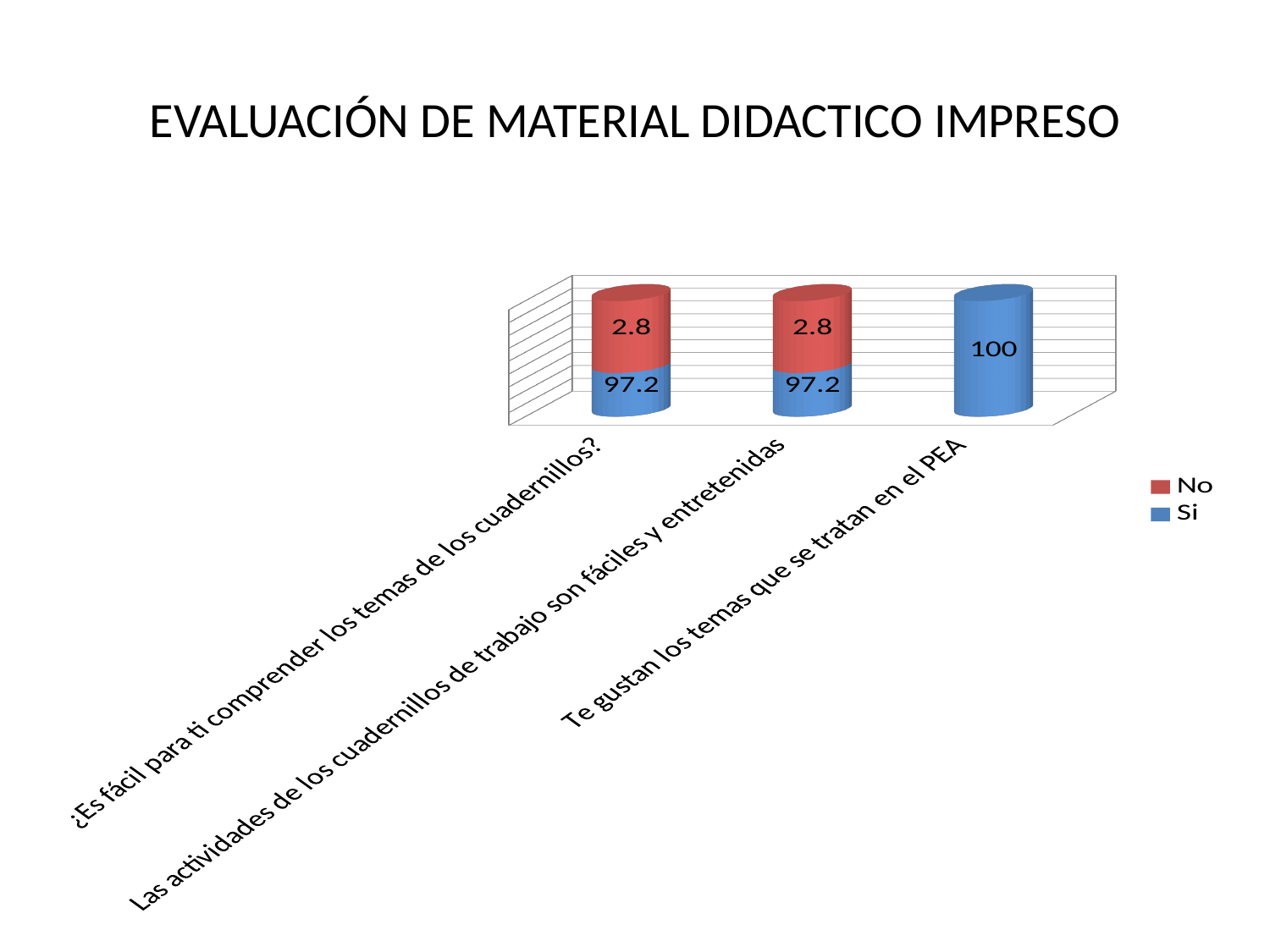
What is the total of the stacked bar for "¿Es fácil para ti comprender los temas de los cuadernillos?"? 100 What is the value of the "No" series for "¿Es fácil para ti comprender los temas de los cuadernillos?"? 2.8 How many categories are shown on the x axis? 3 How many series does the legend list? 2 What is the title of the slide? EVALUACIÓN DE MATERIAL DIDACTICO IMPRESO What is the value of the "No" series for "Las actividades de los cuadernillos de trabajo son fáciles y entretenidas"? 2.8 What kind of chart is shown on the slide? Stacked bar chart What is the value of the "Si" series for "Te gustan los temas que se tratan en el PEA"? 100 Which category has the highest "Si" value? Te gustan los temas que se tratan en el PEA For "¿Es fácil para ti comprender los temas de los cuadernillos?", which is larger, the "Si" value or the "No" value? Si What is the difference between the "Si" and "No" values for "Las actividades de los cuadernillos de trabajo son fáciles y entretenidas"? 94.4 What is the value of the "Si" series for "¿Es fácil para ti comprender los temas de los cuadernillos?"? 97.2